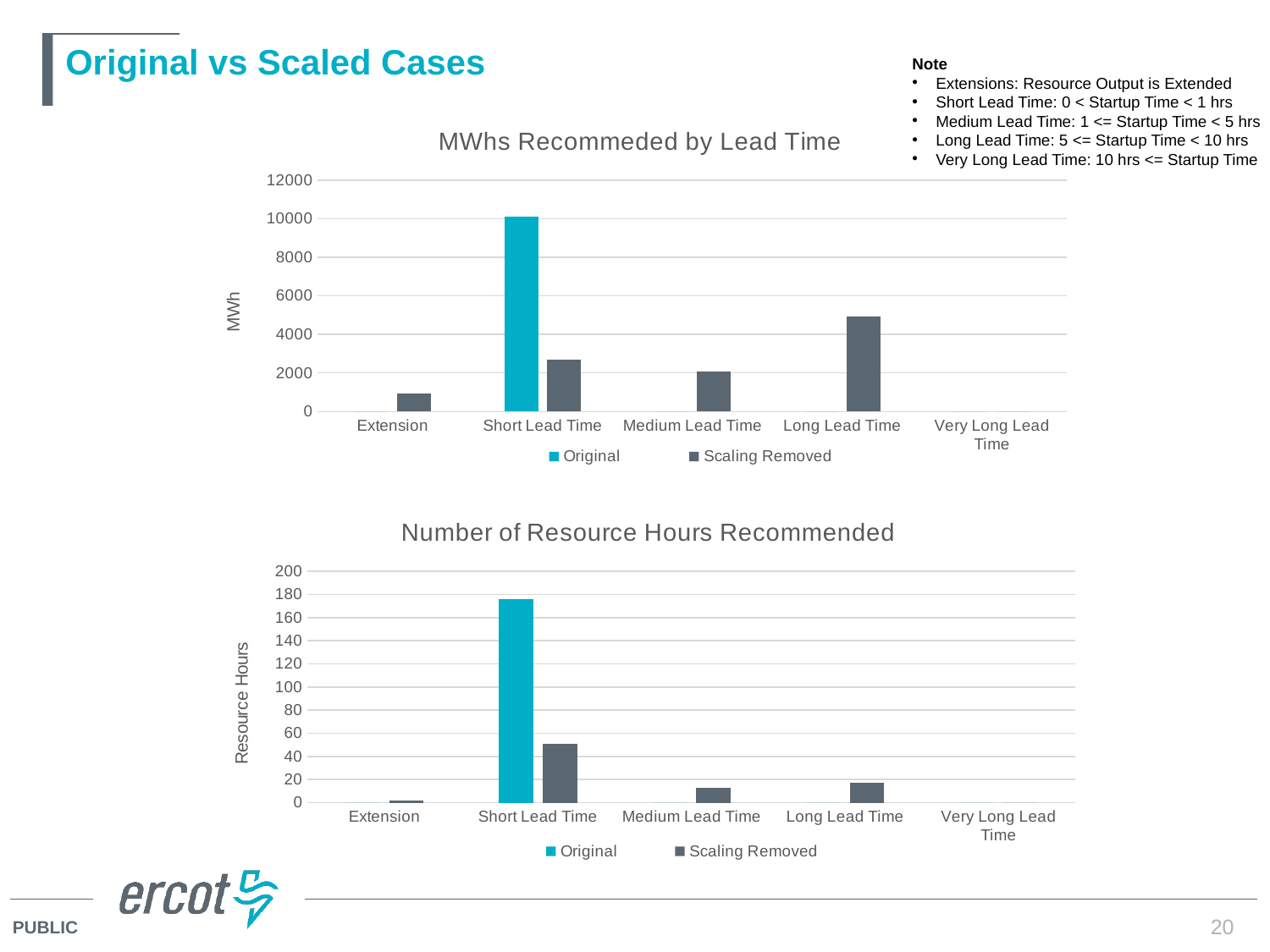
In the top chart (MWhs Recommeded by Lead Time), how many lead time categories are shown on the x axis? 5 In the bottom chart (Number of Resource Hours Recommended), is the Original value for Short Lead Time greater or less than 160? greater In the top chart (MWhs Recommeded by Lead Time), which category has the highest Scaling Removed value? Long Lead Time In the top chart (MWhs Recommeded by Lead Time), is the Original value for Short Lead Time greater or less than 8000? greater In the bottom chart (Number of Resource Hours Recommended), which is larger for the Scaling Removed series: Medium Lead Time or Long Lead Time? Long Lead Time In the bottom chart (Number of Resource Hours Recommended), is the Scaling Removed value for Short Lead Time greater or less than 60? less What kind of chart is the top chart titled "MWhs Recommeded by Lead Time"? bar chart In the bottom chart (Number of Resource Hours Recommended), which category has the highest Original value? Short Lead Time What is the y-axis label of the bottom chart (Number of Resource Hours Recommended)? Resource Hours In the top chart (MWhs Recommeded by Lead Time), how many series does the legend list? 2 In the top chart (MWhs Recommeded by Lead Time), which is larger for the Scaling Removed series: Short Lead Time or Medium Lead Time? Short Lead Time